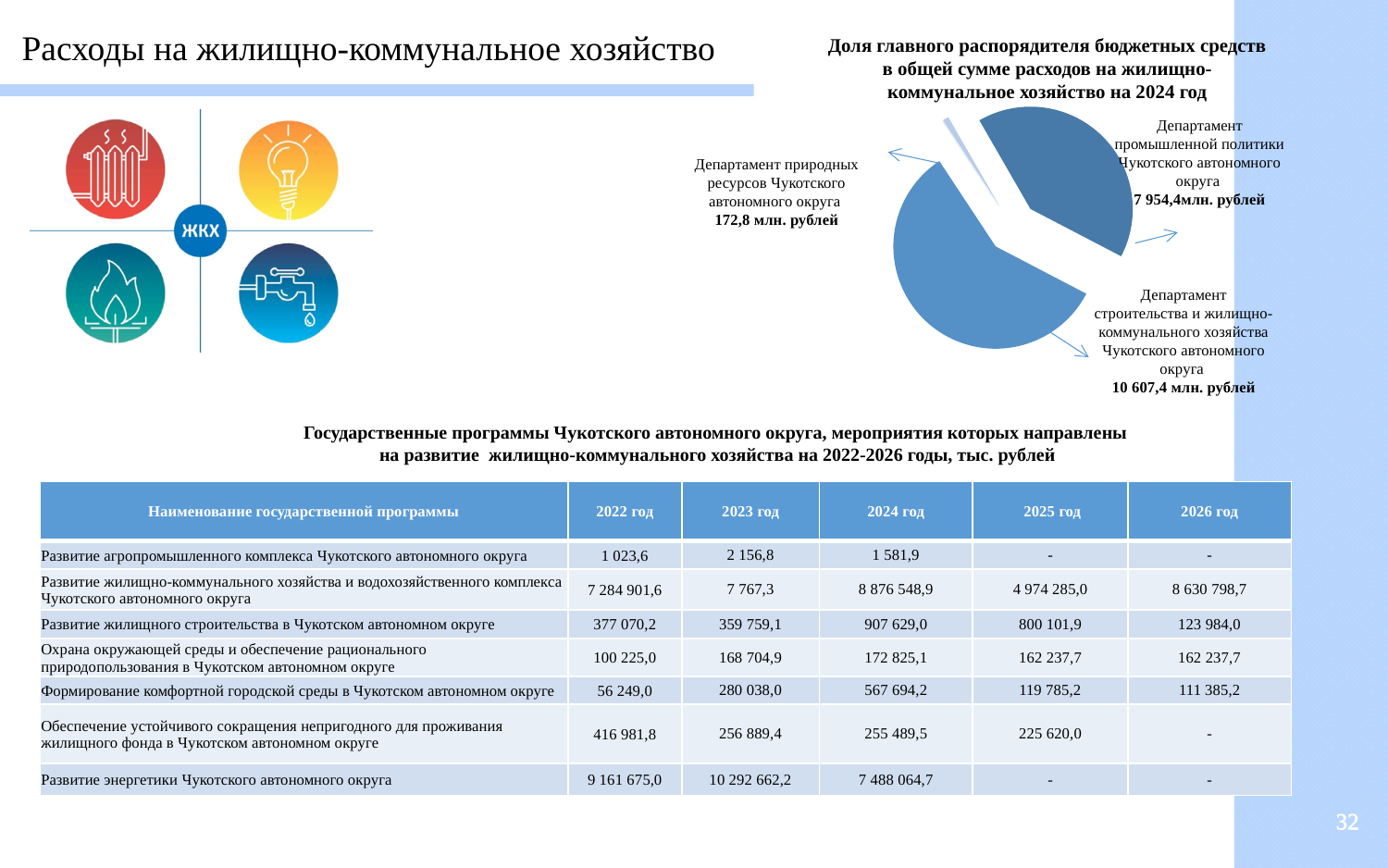
What is the title of the pie chart? Доля главного распорядителя бюджетных средств в общей сумме расходов на жилищно-коммунальное хозяйство на 2024 год In the pie chart, what is the value for Департамент промышленной политики Чукотского автономного округа? 7 954,4 млн. рублей Which department has the largest slice in the pie chart? Департамент строительства и жилищно-коммунального хозяйства Чукотского автономного округа In the pie chart, which is larger: the value for Департамент промышленной политики or the value for Департамент природных ресурсов? Департамент промышленной политики In the pie chart, what is the value for Департамент строительства и жилищно-коммунального хозяйства Чукотского автономного округа? 10 607,4 млн. рублей What is the total of the three values shown in the pie chart? 18 734,6 млн. рублей In the pie chart, what is the difference between the value for Департамент промышленной политики and the value for Департамент природных ресурсов? 7 781,6 млн. рублей What type of chart is shown in the upper right of the slide? Pie chart In the pie chart, what is the value for Департамент природных ресурсов Чукотского автономного округа? 172,8 млн. рублей In the pie chart, what is the difference between the value for Департамент строительства и жилищно-коммунального хозяйства and the value for Департамент промышленной политики? 2 653,0 млн. рублей